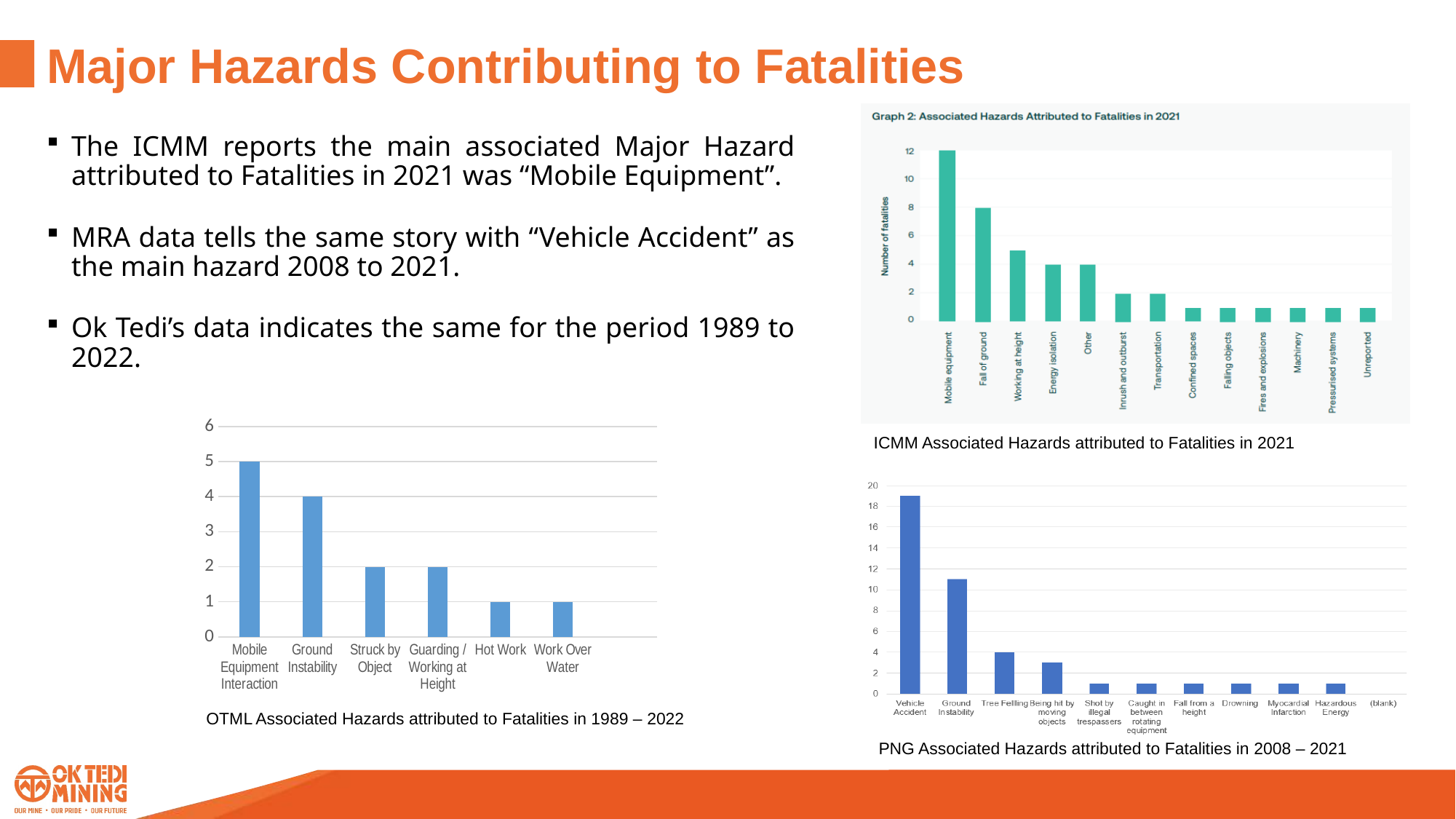
In the OTML Associated Hazards chart (bottom left), what is the difference between Ground Instability and Struck by Object? 2 In the PNG Associated Hazards chart (bottom right), what is the value for Tree Felling? 4 In the ICMM chart (Graph 2, top right), what is the number of fatalities for Fall of ground? 8 In the ICMM chart (Graph 2, top right), what is the number of fatalities for Mobile equipment? 12 In the PNG Associated Hazards chart (bottom right), which category has the highest value? Vehicle Accident In the ICMM chart (Graph 2, top right), which is larger: Energy isolation or Transportation? Energy isolation What type of chart is the PNG Associated Hazards chart (bottom right)? Bar chart How many categories are shown in the ICMM chart (Graph 2, top right)? 13 In the PNG Associated Hazards chart (bottom right), is the value for Vehicle Accident greater or less than 18? greater In the OTML Associated Hazards chart (bottom left), what is the value for Mobile Equipment Interaction? 5 How many categories are shown in the OTML Associated Hazards chart (bottom left)? 6 In the OTML Associated Hazards chart (bottom left), which category has the highest value? Mobile Equipment Interaction